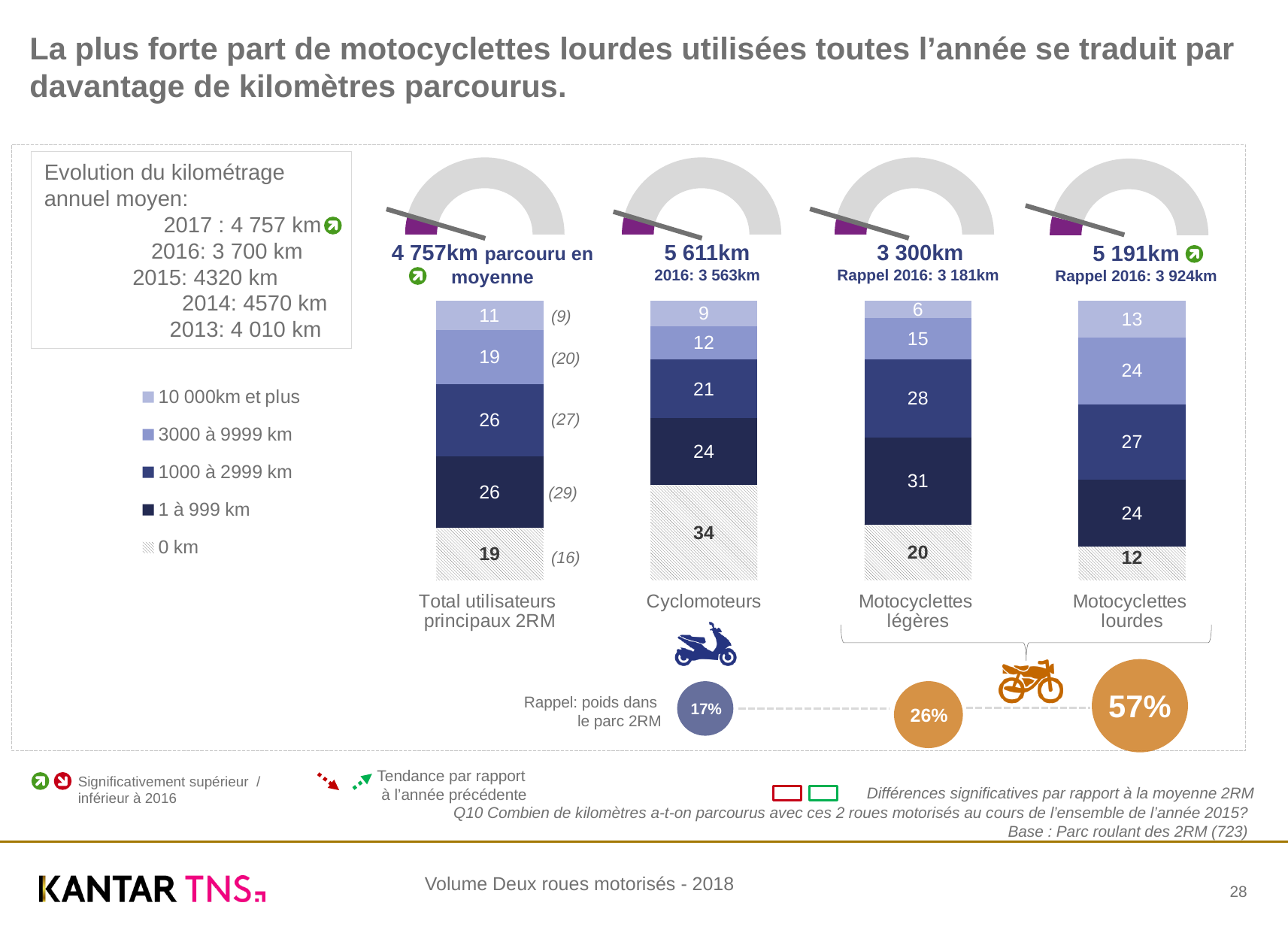
What average annual kilometrage is shown above the Cyclomoteurs bar? 5 611km What is the value of the "0 km" segment for Cyclomoteurs in the stacked bar chart? 34 How many series does the legend of the stacked bar chart list? 5 Which is larger: the "3000 à 9999 km" value for Motocyclettes lourdes or for Cyclomoteurs? Motocyclettes lourdes How many categories are shown on the x axis of the stacked bar chart? 4 What is the total of the stacked bar for Motocyclettes légères? 100 What is the difference between the "0 km" values for Cyclomoteurs and Motocyclettes lourdes? 22 Which category has the highest value for the "0 km" segment? Cyclomoteurs What is the value of the "1 à 999 km" segment for Motocyclettes légères? 31 Which category has the lowest value for the "10 000km et plus" segment? Motocyclettes légères What is the value of the "10 000km et plus" segment for Motocyclettes lourdes? 13 What kind of chart is used to show the kilometre distribution by category? Stacked bar chart